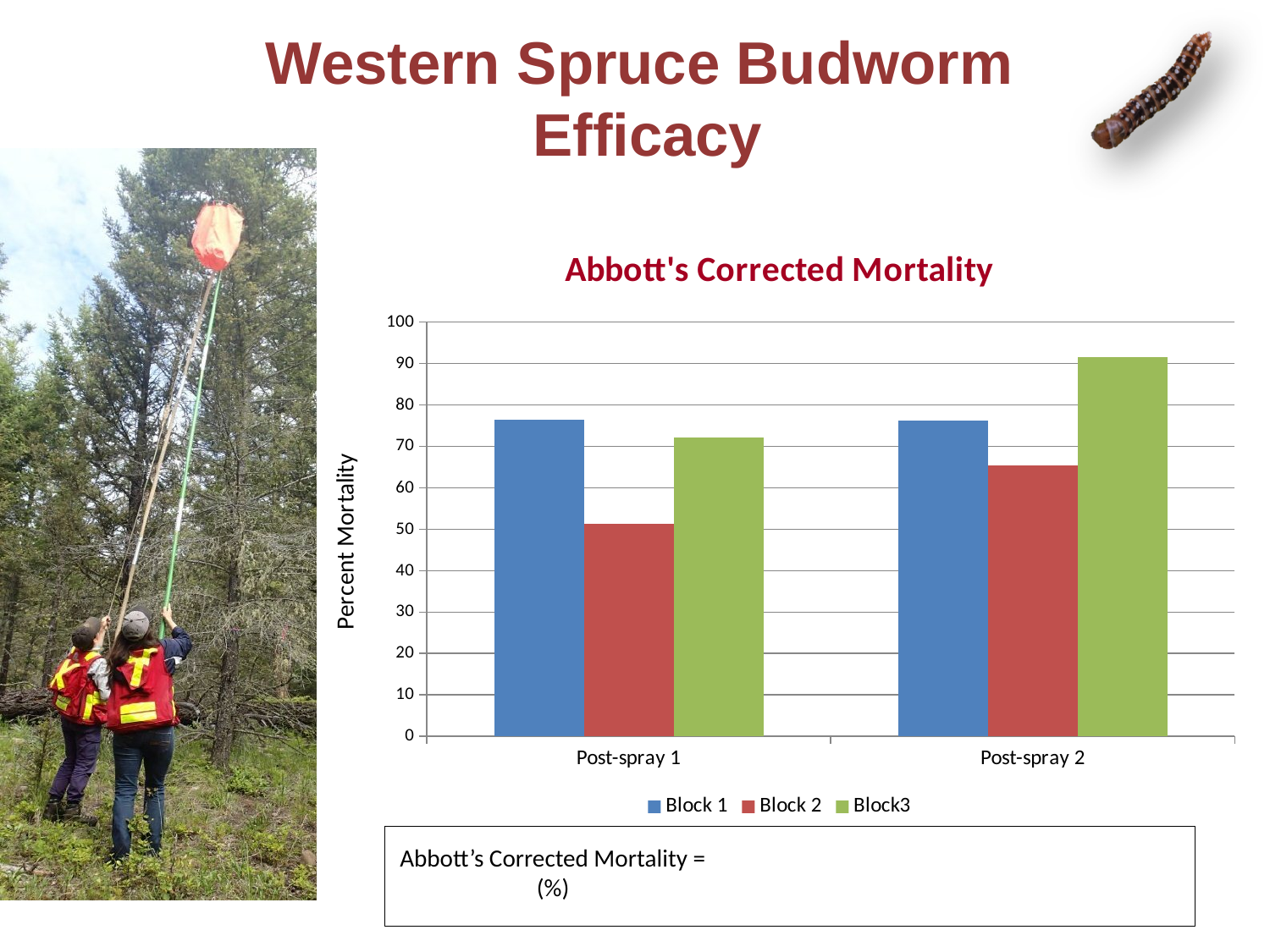
Which block has the highest mortality in Post-spray 2? Block3 What is the title of the chart? Abbott's Corrected Mortality How many categories are shown on the x axis of the chart? 2 Is the value for Block 2 in Post-spray 1 greater or less than 60? less Does the value for Block3 rise or fall from Post-spray 1 to Post-spray 2? rise Is the value for Block3 in Post-spray 2 greater or less than 90? greater What kind of chart is shown on the slide? bar chart How many series does the chart legend list? 3 Which block has the lowest mortality in Post-spray 1? Block 2 What is the label of the vertical axis? Percent Mortality Which block has the highest mortality in Post-spray 1? Block 1 Which is larger: Block 2 in Post-spray 1 or Block 2 in Post-spray 2? Block 2 in Post-spray 2